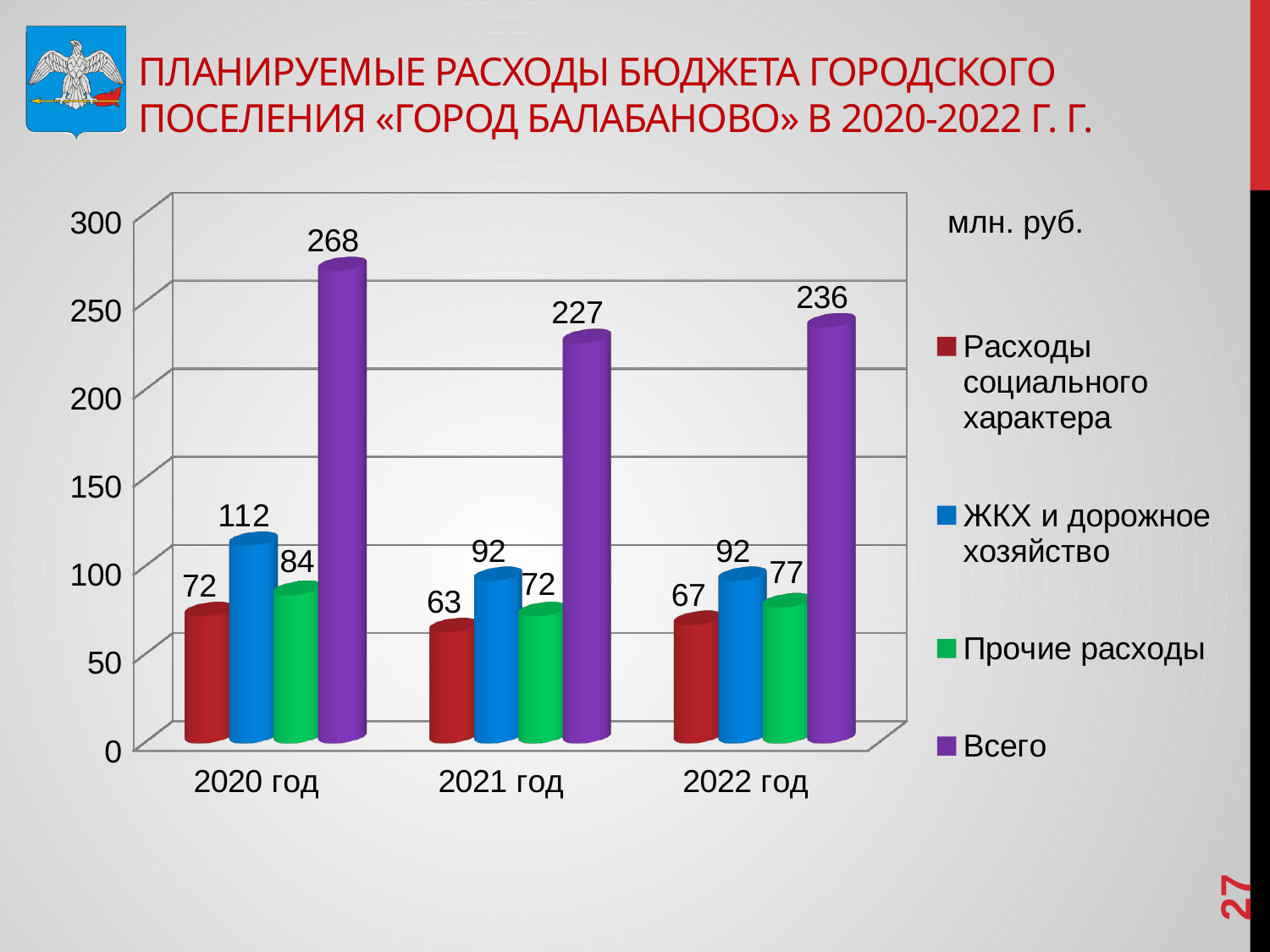
In which year is «Всего» the highest? 2020 год Which is larger: «Прочие расходы» in 2022 год or «Прочие расходы» in 2021 год? 2022 год What is the value of «Всего» for 2020 год? 268 What is the difference between «Всего» in 2020 год and 2021 год? 41 What kind of chart is shown on the slide? bar chart In which year is «Расходы социального характера» the lowest? 2021 год What is the value of «Расходы социального характера» for 2022 год? 67 What unit is indicated next to the chart? млн. руб. What is the value of «ЖКХ и дорожное хозяйство» for 2021 год? 92 What is the value of «Прочие расходы» for 2020 год? 84 How many series does the legend list? 4 How many years (categories) are shown on the x axis? 3